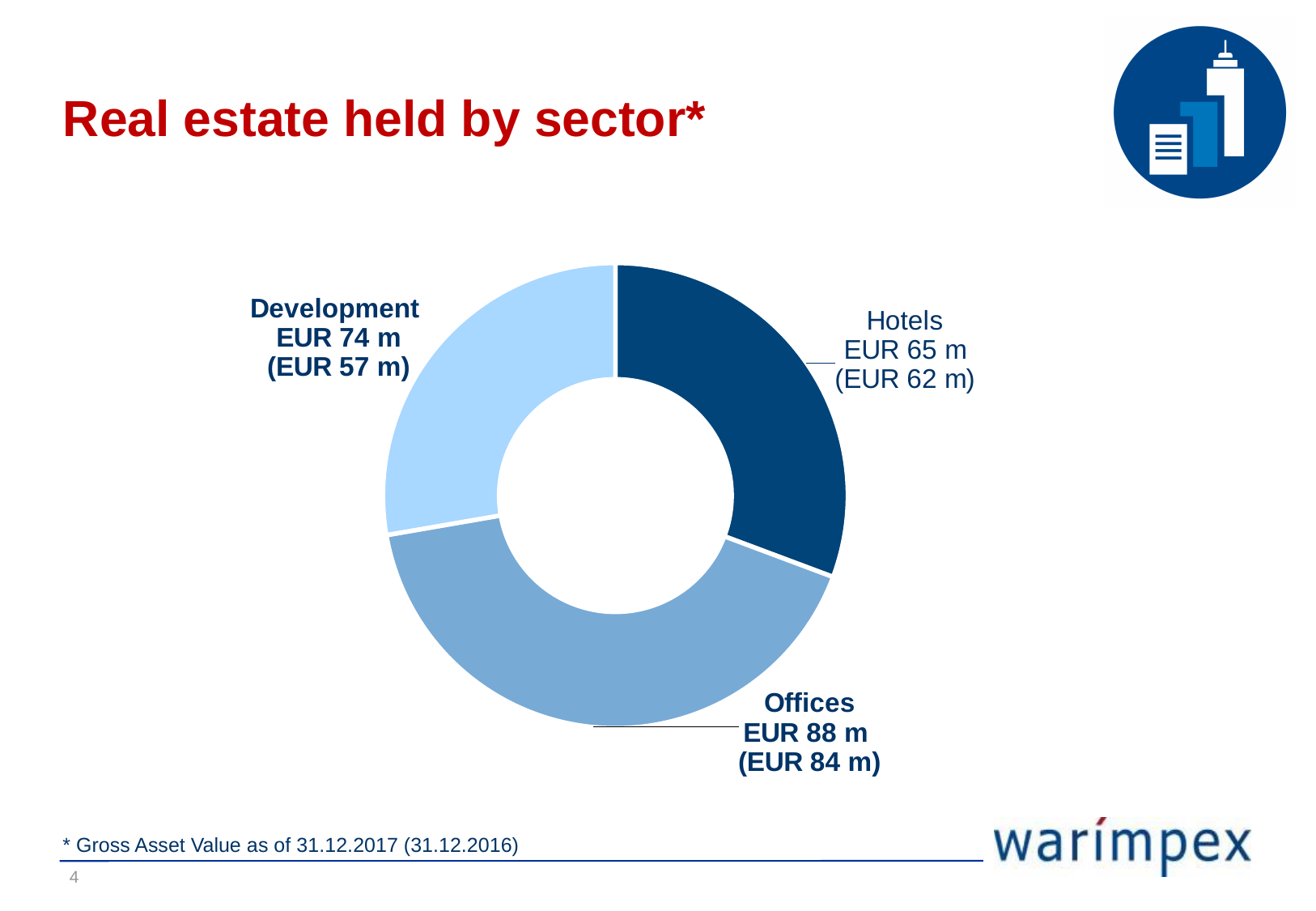
What is the value shown in parentheses (31.12.2016) for Hotels? EUR 62 m What is the difference between the Offices and Hotels values as of 31.12.2017? EUR 23 m What is the value shown for Offices as of 31.12.2017? EUR 88 m Which is larger as of 31.12.2017, Development or Hotels? Development What is the value shown in parentheses (31.12.2016) for Development? EUR 57 m By how much did the Development value change from 31.12.2016 to 31.12.2017? EUR 17 m Which sector has the lowest value as of 31.12.2017? Hotels How many sectors are shown in the chart? 3 What is the value shown for Development as of 31.12.2017? EUR 74 m Which sector has the highest value as of 31.12.2017? Offices What kind of chart is shown on the slide? Pie chart (doughnut) What is the value shown for Hotels as of 31.12.2017? EUR 65 m